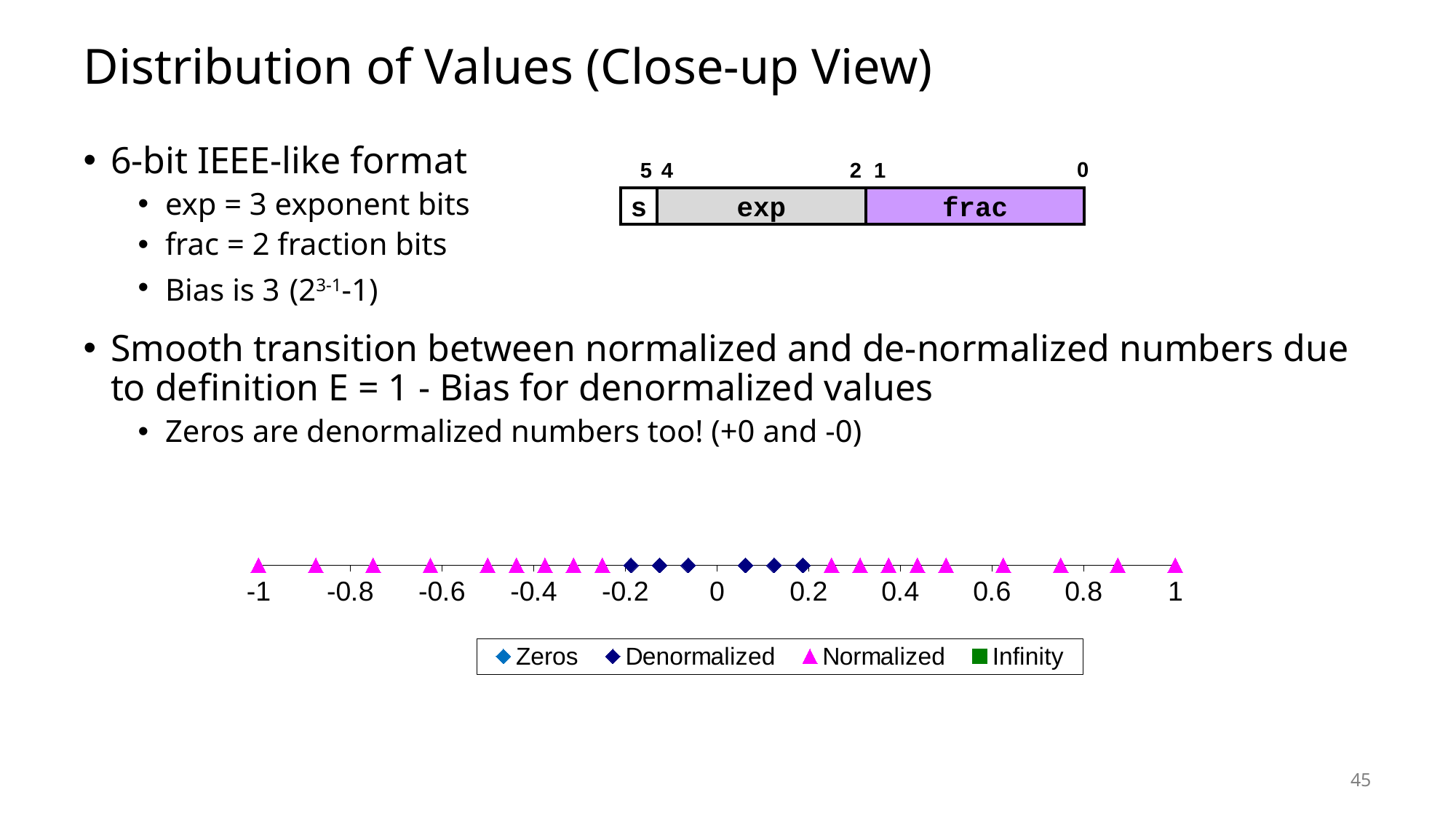
Is the largest Denormalized value plotted greater or less than 0.2? less What are the four entries in the chart legend? Zeros, Denormalized, Normalized, Infinity How many series does the chart legend list? 4 What is the smallest value at which a Normalized point is plotted? -1 How many Normalized (triangle) points are plotted on the positive side of the axis (greater than 0)? 9 What kind of chart is shown at the bottom of the slide? scatter chart Which series, Denormalized or Normalized, has its points closer to 0 on the axis? Denormalized How many Denormalized (diamond) points are plotted on the chart? 6 What is the rightmost tick label on the chart's x axis? 1 Which series is plotted with magenta triangle markers? Normalized What is the leftmost tick label on the chart's x axis? -1 What is the largest value at which a Normalized point is plotted? 1